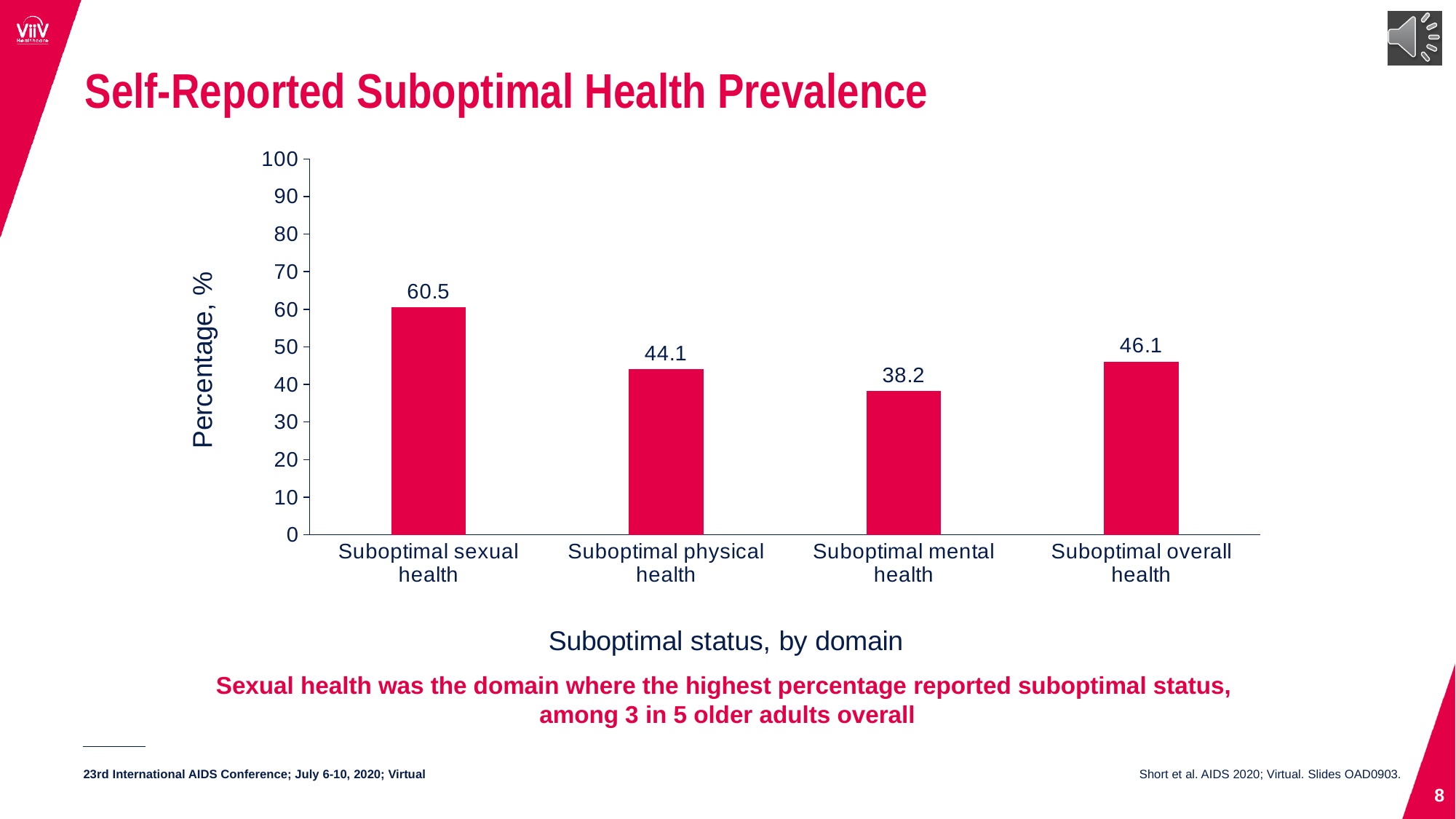
Is the value for Suboptimal mental health greater or less than 40? less What is the value for Suboptimal sexual health? 60.5 What is the value for Suboptimal overall health? 46.1 Which domain has the highest percentage? Suboptimal sexual health How many domains are shown on the chart? 4 What kind of chart is shown on the slide? Bar chart What is the value for Suboptimal physical health? 44.1 Which domain has the lowest percentage? Suboptimal mental health What is the label of the y axis? Percentage, % Which is larger, the value for Suboptimal overall health or Suboptimal physical health? Suboptimal overall health What is the difference between the values for Suboptimal sexual health and Suboptimal mental health? 22.3 What is the value for Suboptimal mental health? 38.2